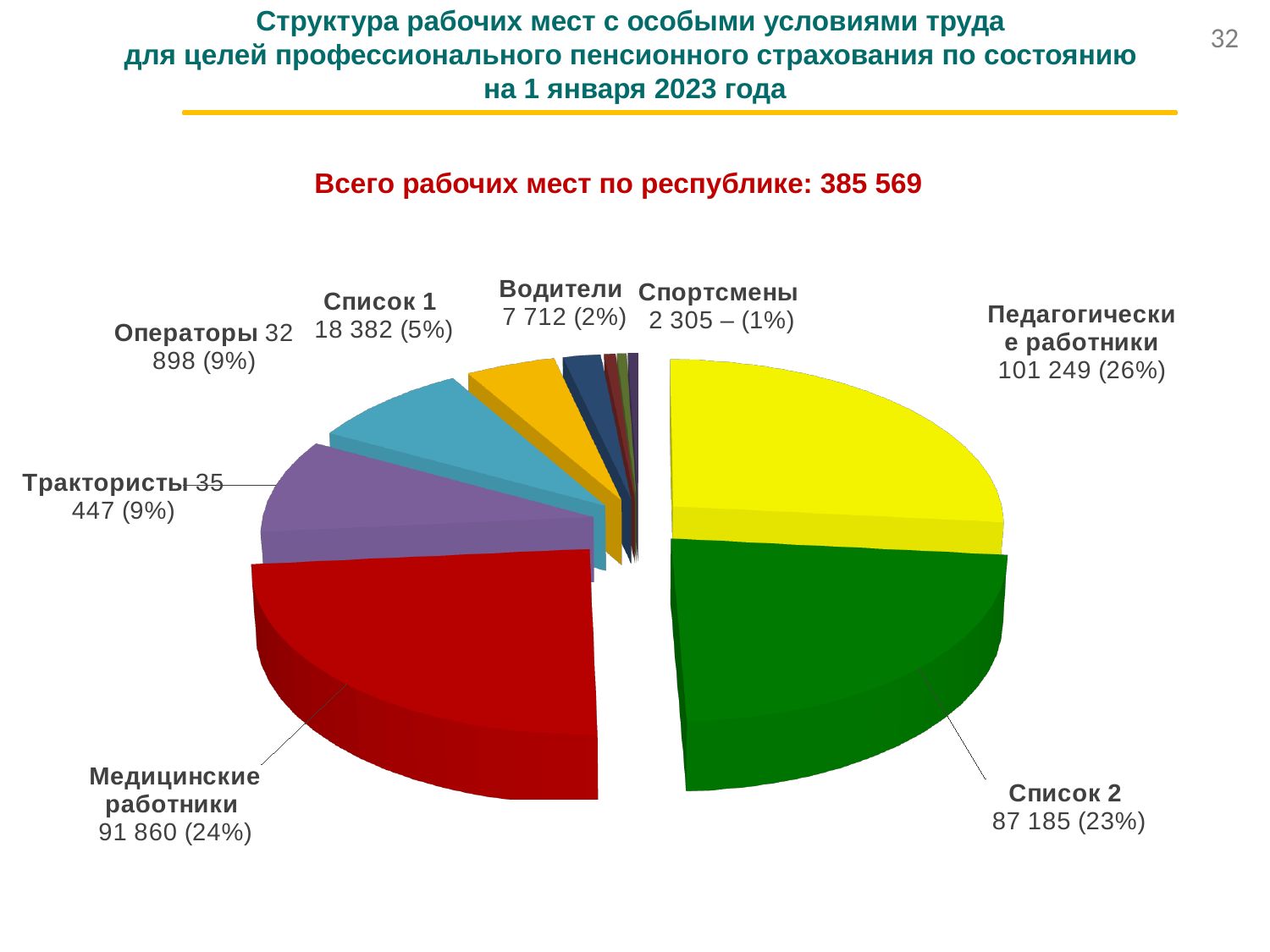
What value is shown for Водители? 7 712 (2%) What kind of chart is shown on the slide? pie chart How many workplaces are shown for Педагогические работники? 101 249 (26%) Which labelled category has the largest slice? Педагогические работники What share of the pie does Список 1 represent? 5% What value is shown for Медицинские работники? 91 860 (24%) Which labelled category has the smallest slice? Спортсмены Which is larger, Медицинские работники or Список 2? Медицинские работники What share of the pie do Трактористы represent? 9% What total number of workplaces across the republic is stated on the slide? 385 569 What value is shown for Список 2? 87 185 (23%) What is the difference between the values for Педагогические работники and Список 2? 14 064